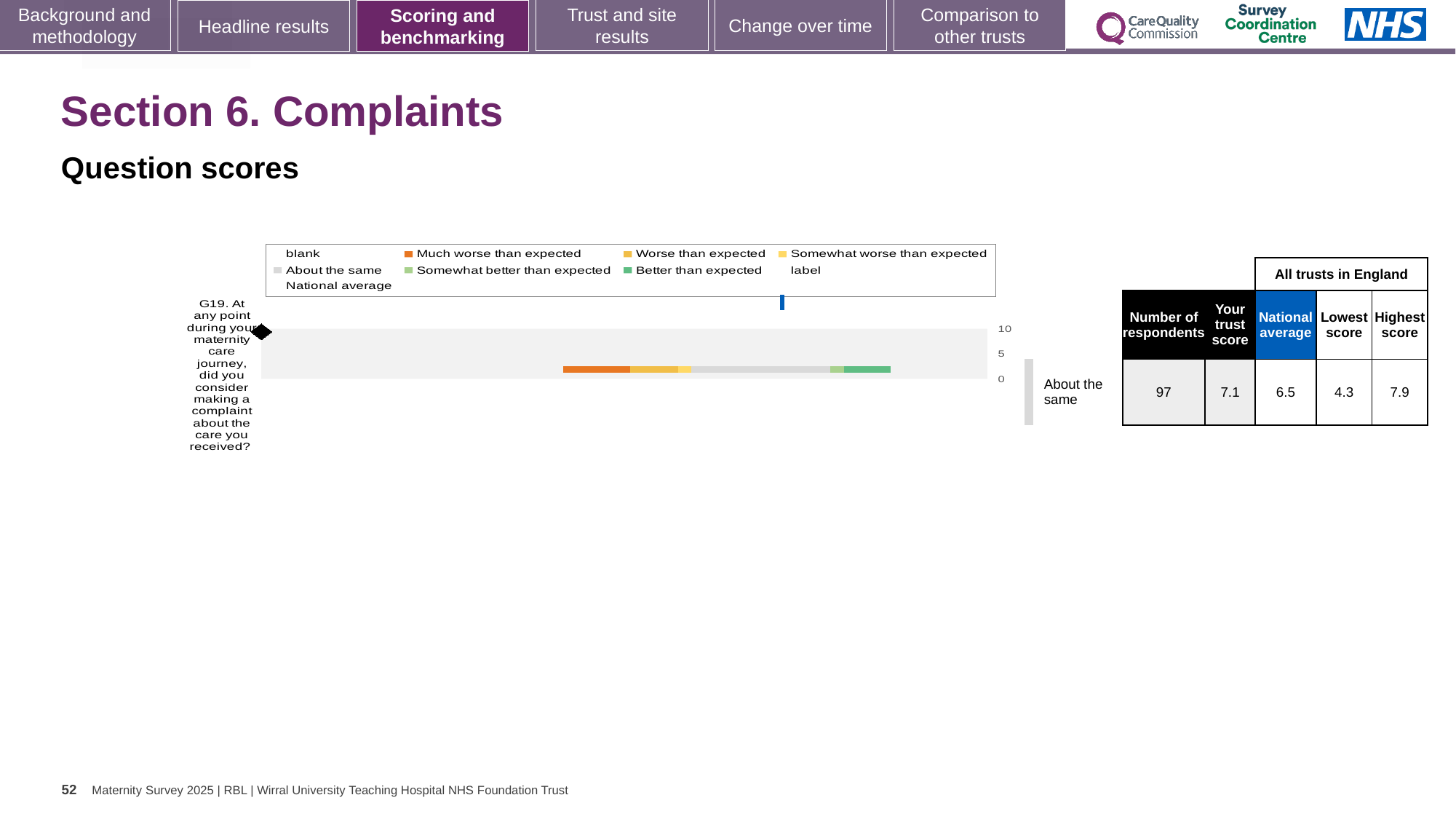
What is the lowest score among all trusts in England for question G19? 4.3 What is the difference between the highest score and the lowest score for question G19? 3.6 What is the trust score for question G19 shown in the table next to the chart? 7.1 Which is larger for question G19: the trust score or the national average? trust score How many questions (categories) are plotted on the chart? 1 What is the maximum value shown on the chart's score axis? 10 What kind of chart is used to show the question score for G19? bar chart How many respondents answered question G19? 97 What is the national average score for question G19? 6.5 What is the highest score among all trusts in England for question G19? 7.9 What is the difference between the trust score and the national average for question G19? 0.6 What benchmark category is the trust's result for question G19 given? About the same